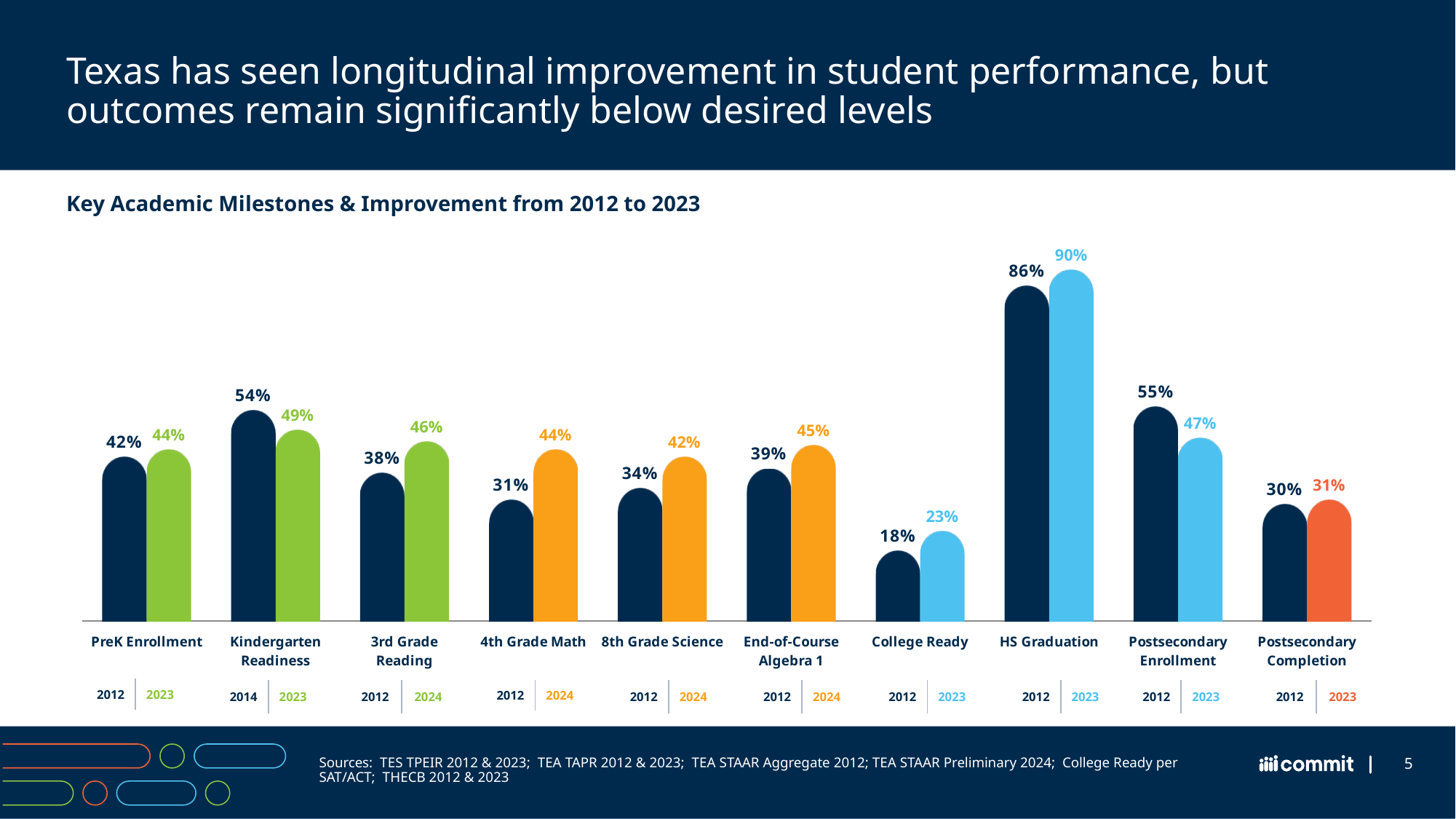
What is the difference between the 2024 and 2012 values for 3rd Grade Reading? 8% Which milestone has the lowest later-year (2023/2024) value? College Ready Which milestone has the highest 2012 value? HS Graduation What is the 2014 value for Kindergarten Readiness? 54% What is the 2024 value for 4th Grade Math? 44% Which is larger for Postsecondary Enrollment, the 2012 value or the 2023 value? 2012 What is the difference between the 2012 and 2023 values for Postsecondary Enrollment? 8% What is the 2012 value for College Ready? 18% What kind of chart is shown on the slide? Bar chart How many milestone categories are shown on the x axis? 10 What is the title of the chart? Key Academic Milestones & Improvement from 2012 to 2023 What is the 2023 value for HS Graduation? 90%